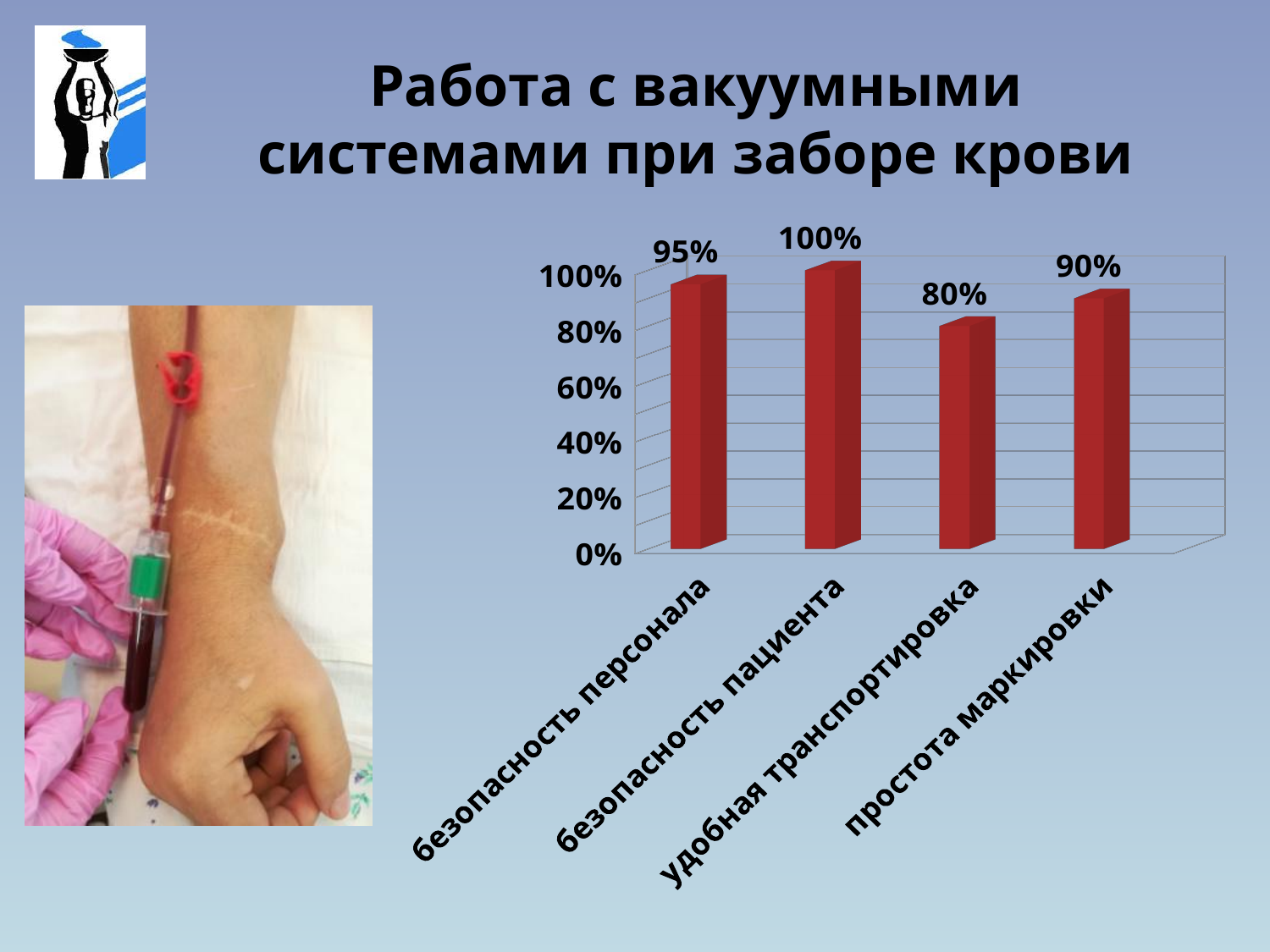
What is the difference between the values for безопасность пациента and удобная транспортировка? 20% What is the value for безопасность персонала? 95% What colour are the bars in the chart? red What is the difference between the values for безопасность персонала and простота маркировки? 5% Which category has the lowest value? удобная транспортировка Which is larger, the value for безопасность персонала or the value for простота маркировки? безопасность персонала What is the value for безопасность пациента? 100% Which category has the highest value? безопасность пациента How many categories are shown in the chart? 4 What is the value for простота маркировки? 90% What kind of chart is shown on the slide? bar chart What is the value for удобная транспортировка? 80%